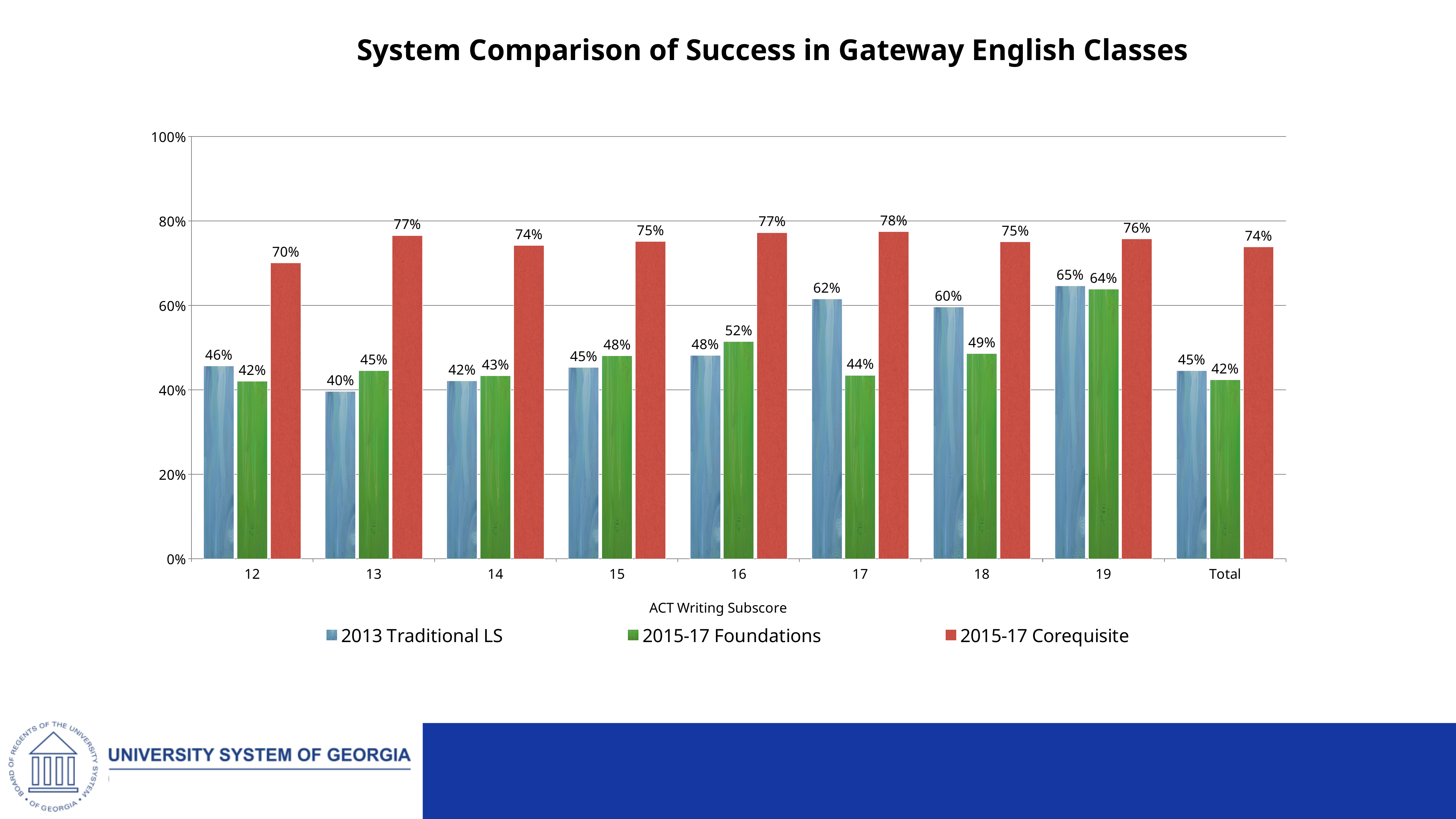
For ACT Writing Subscore 18, which is larger: the 2013 Traditional LS rate or the 2015-17 Foundations rate? 2013 Traditional LS What kind of chart is shown on the slide? bar chart What is the x-axis label of the chart? ACT Writing Subscore Which ACT Writing Subscore category has the highest 2015-17 Corequisite success rate? 17 Is the 2015-17 Corequisite value for ACT Writing Subscore 12 greater or less than 60%? greater What is the 2013 Traditional LS success rate for ACT Writing Subscore 13? 40% What is the 2015-17 Corequisite success rate for ACT Writing Subscore 17? 78% Which ACT Writing Subscore category has the lowest 2015-17 Corequisite success rate? 12 How many categories are shown on the x axis? 9 What is the 2015-17 Foundations success rate for the Total category? 42% How many series does the legend list? 3 What is the difference between the 2015-17 Corequisite and 2013 Traditional LS success rates for the Total category? 29%